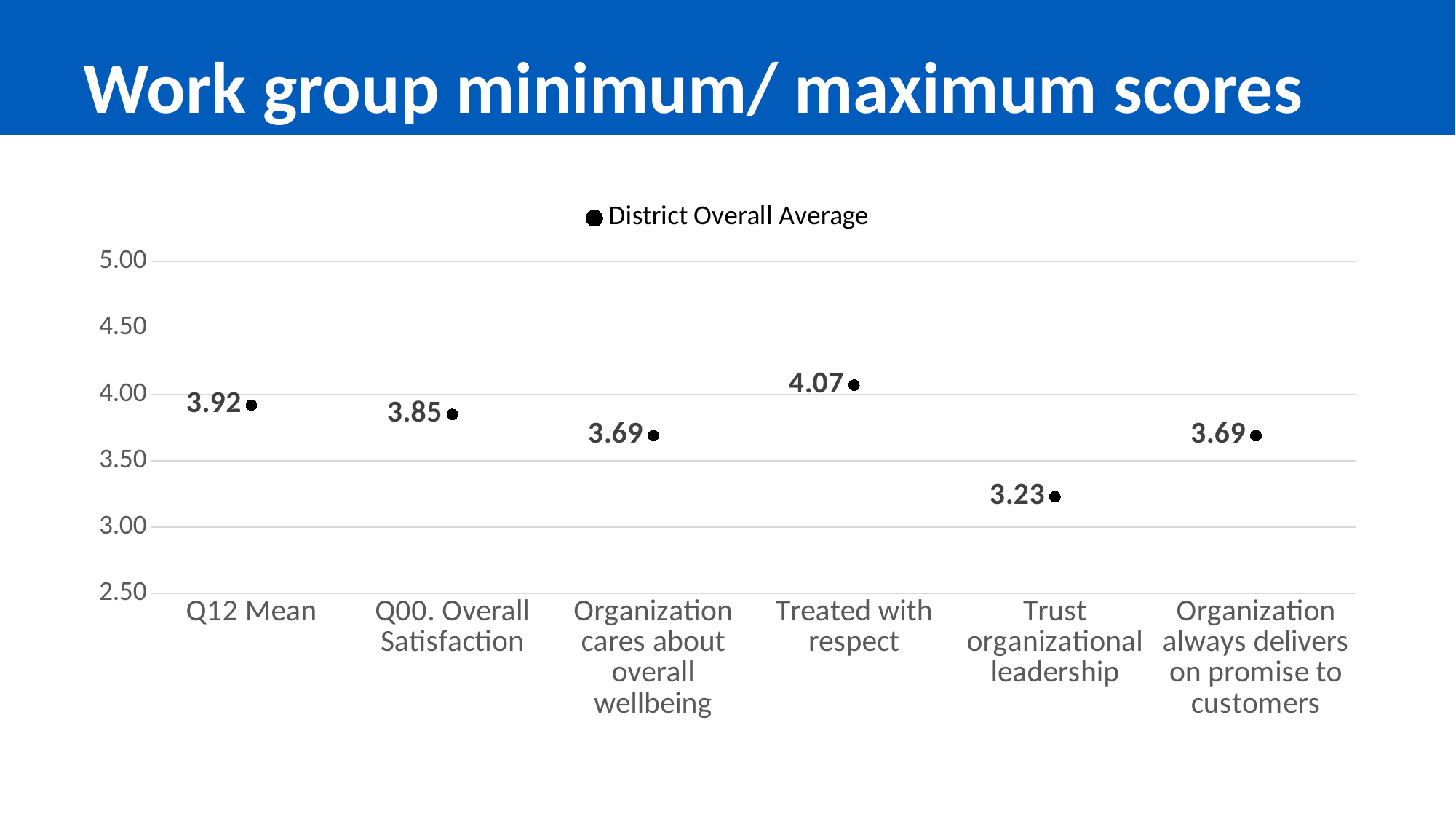
What is the District Overall Average for Q00. Overall Satisfaction? 3.85 What is the District Overall Average for Trust organizational leadership? 3.23 Which is larger, the District Overall Average for Q12 Mean or for Q00. Overall Satisfaction? Q12 Mean Which category has the lowest District Overall Average? Trust organizational leadership What is the District Overall Average for Q12 Mean? 3.92 What is the title of the slide containing the chart? Work group minimum/ maximum scores What is the difference between the District Overall Average for Treated with respect and for Trust organizational leadership? 0.84 Is the District Overall Average for Trust organizational leadership greater or less than 3.50? less How many categories are shown on the x axis of the chart? 6 What is the District Overall Average for Treated with respect? 4.07 Which category has the highest District Overall Average? Treated with respect How many series does the chart legend list? 1